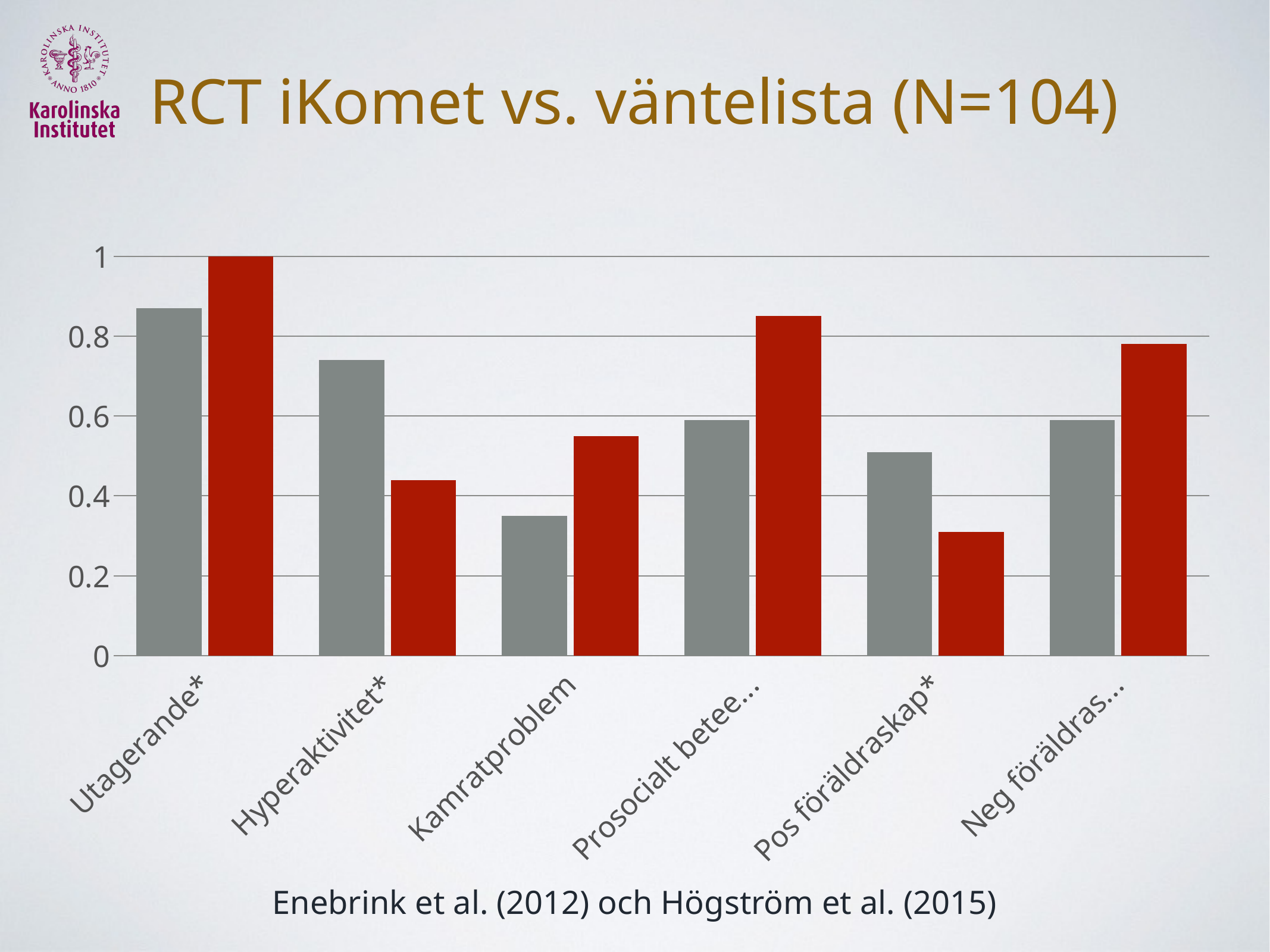
What kind of chart is shown on the slide? bar chart Among the grey bars, which category has the highest value? Utagerande* Is the red bar for Pos föräldraskap* greater or less than 0.4? less What is the title of the chart slide? RCT iKomet vs. väntelista (N=104) Among the grey bars, which category has the lowest value? Kamratproblem For Kamratproblem, which bar is taller, the grey bar or the red bar? the red bar For Hyperaktivitet*, which bar is taller, the grey bar or the red bar? the grey bar Is the grey bar for Hyperaktivitet* greater or less than 0.6? greater Which category has the tallest bar in the chart? Utagerande* Is the grey bar for Kamratproblem greater or less than 0.4? less How many categories are shown on the x axis of the chart? 6